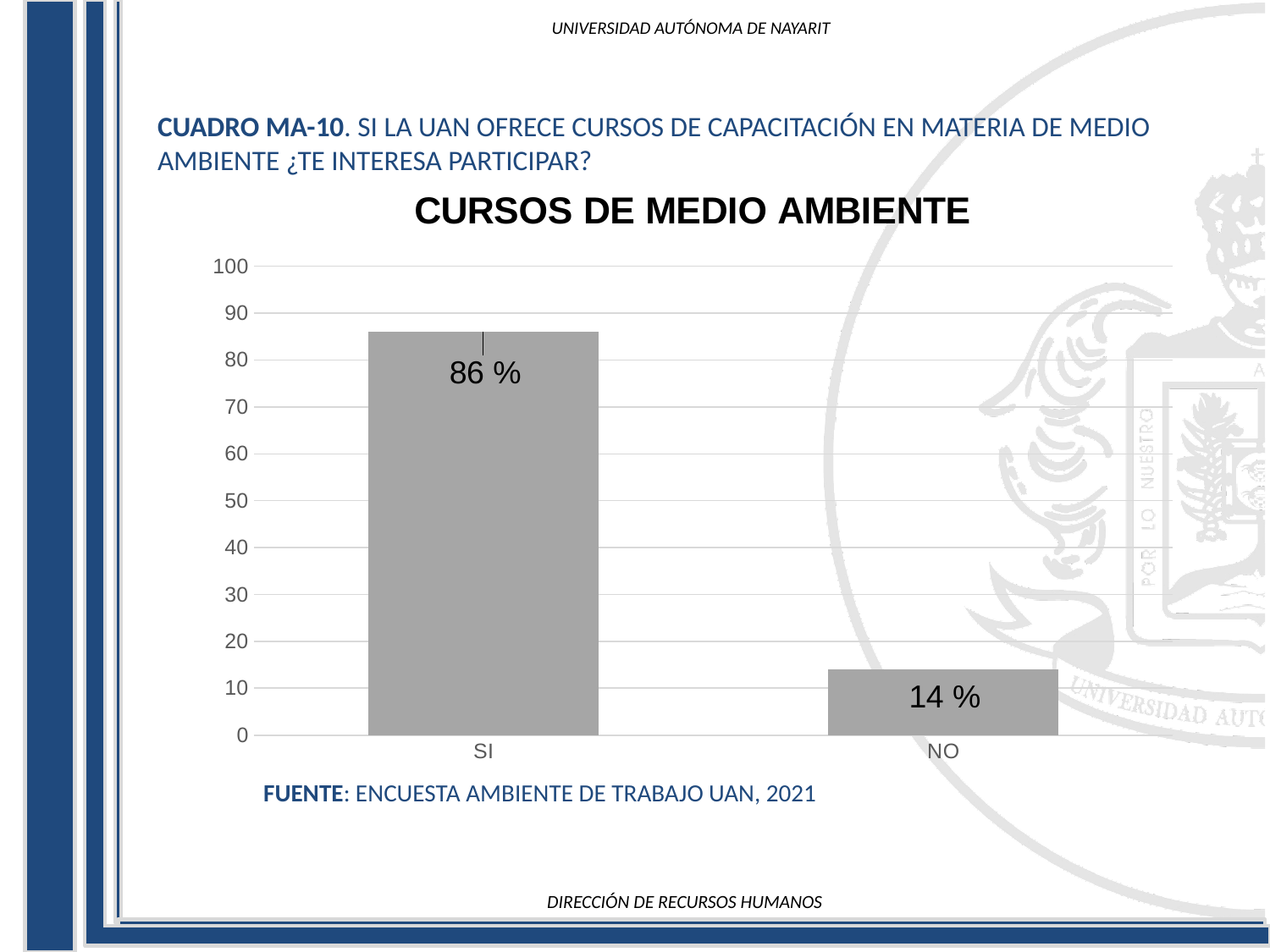
What is the highest value shown on the y axis? 100 What is the title of the chart? CURSOS DE MEDIO AMBIENTE Which category has the lowest value? NO Which category has the highest value? SI Which is larger, the value for SI or the value for NO? SI How many categories are shown on the x axis? 2 What is the value for NO? 14 % What kind of chart is shown? bar chart Is the value for SI greater or less than 80? greater What is the difference between the values for SI and NO? 72 % Is the value for NO greater or less than 20? less What is the value for SI? 86 %